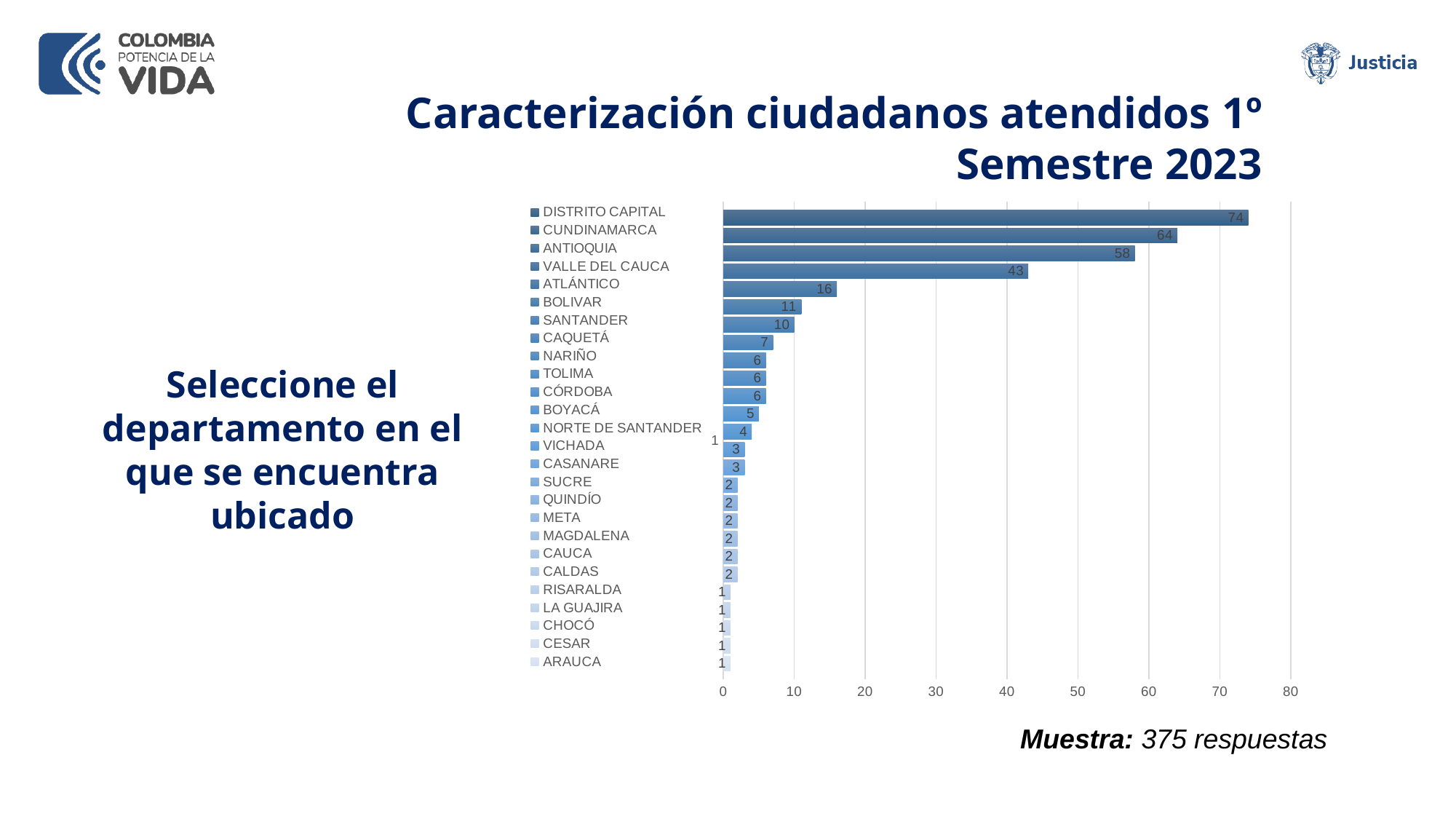
What is the sample size stated below the chart? 375 respuestas Which department has the highest value? DISTRITO CAPITAL What is the value for VALLE DEL CAUCA? 43 What type of chart is shown on the slide? bar chart Is the value for CUNDINAMARCA greater or less than 60? greater What is the difference between the values for ANTIOQUIA and VALLE DEL CAUCA? 15 How many departments are shown in the chart? 26 Which has a larger value, BOLIVAR or CAQUETÁ? BOLIVAR What is the value for ATLÁNTICO? 16 What is the value for SANTANDER? 10 What is the value for DISTRITO CAPITAL? 74 What is the difference between the values for DISTRITO CAPITAL and CUNDINAMARCA? 10